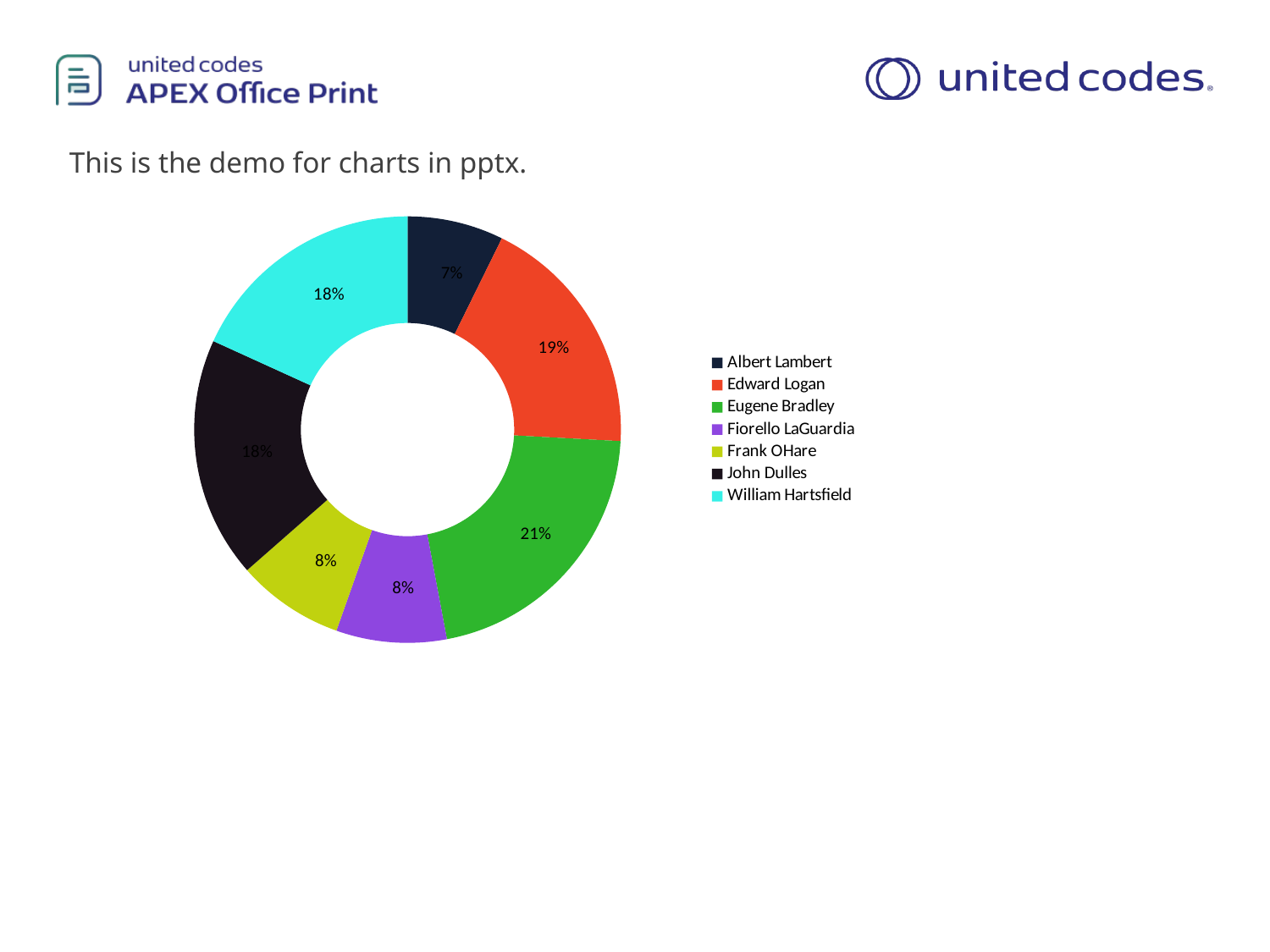
Which category has the smallest slice in the doughnut chart? Albert Lambert What share of the doughnut chart does John Dulles hold? 18% What is the difference in percentage points between Eugene Bradley's share and Albert Lambert's share? 14 Which category has the largest slice in the doughnut chart? Eugene Bradley What share of the doughnut chart does Eugene Bradley hold? 21% What is the combined share of Fiorello LaGuardia and Frank OHare? 16% What share of the doughnut chart does Albert Lambert hold? 7% Which has the larger share, Edward Logan or Fiorello LaGuardia? Edward Logan Which colour represents William Hartsfield in the doughnut chart? Cyan How many categories does the legend of the doughnut chart list? 7 What kind of chart is shown on the slide? Doughnut chart